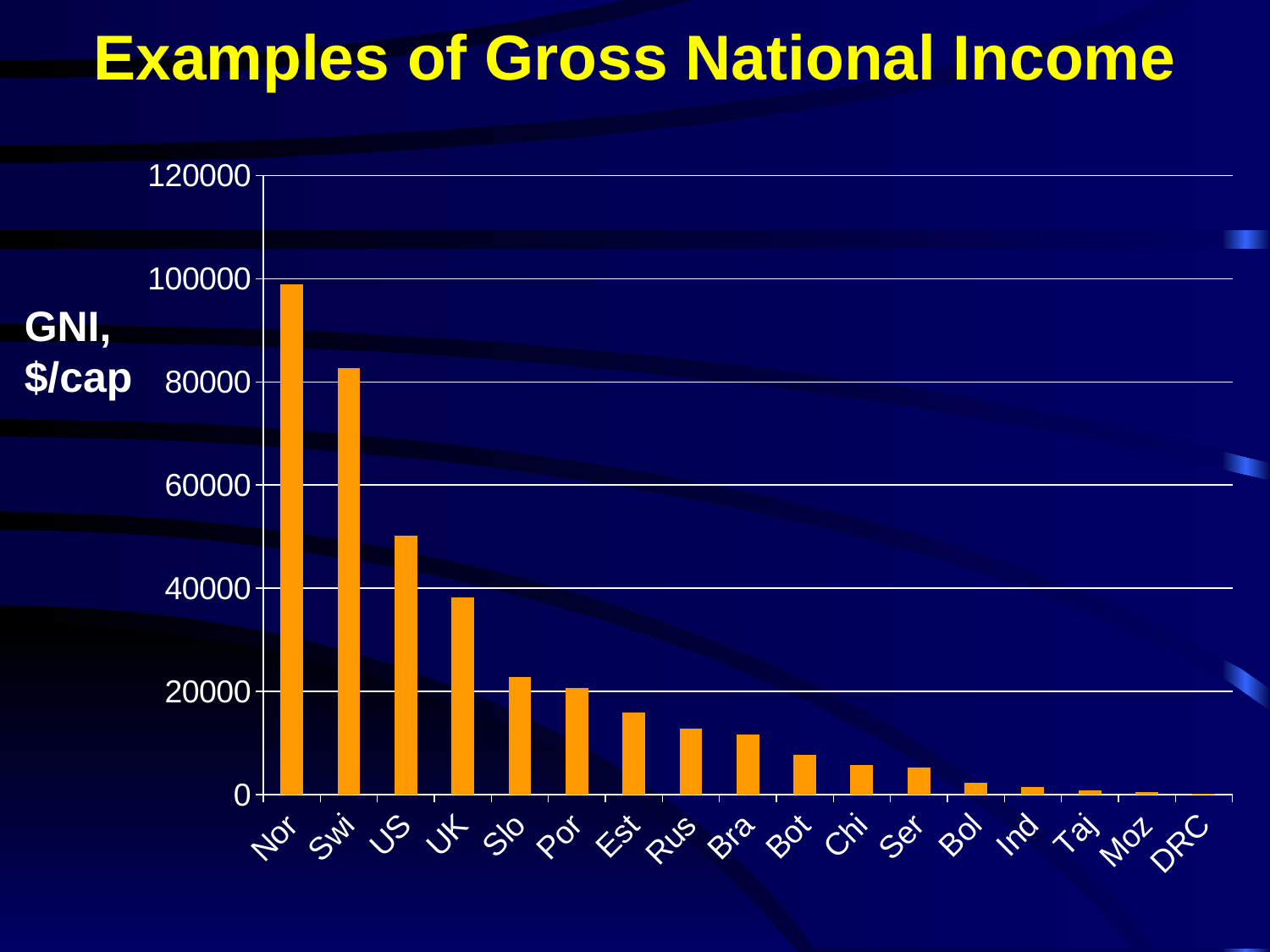
Is the value for UK greater or less than 60000? less Is the value for Nor greater or less than 80000? greater What kind of chart is shown on the slide? bar chart Which country has the highest GNI per capita in the chart? Nor Is the value for Est greater or less than 20000? less Which has a larger GNI per capita, US or UK? US Do the values rise or fall moving from left to right along the x axis? fall How many countries are shown on the x axis of the chart? 17 Which has a larger GNI per capita, Nor or Swi? Nor What is the label on the vertical axis of the chart? GNI, $/cap